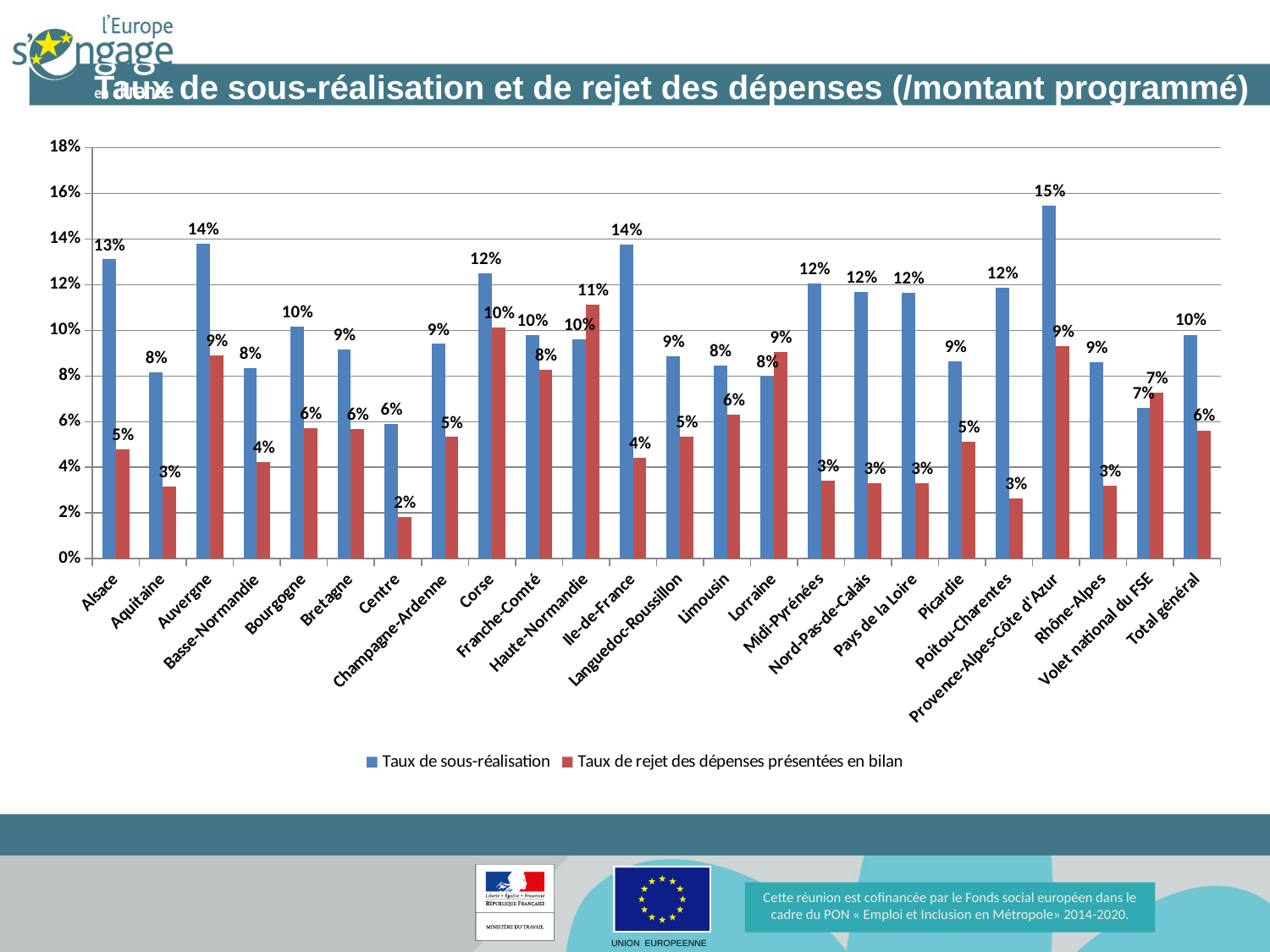
What is the Taux de sous-réalisation for Total général? 10% Which category has the highest Taux de rejet des dépenses présentées en bilan? Haute-Normandie Which is larger: the Taux de sous-réalisation for Alsace or for Aquitaine? Alsace Which region has the highest Taux de sous-réalisation? Provence-Alpes-Côte d'Azur How many series does the legend list? 2 Is the Taux de sous-réalisation for Auvergne greater or less than 12%? greater Which category has the lowest Taux de rejet des dépenses présentées en bilan? Centre What is the Taux de sous-réalisation for Alsace? 13% What kind of chart is shown on the slide? Bar chart What is the difference between the Taux de sous-réalisation and the Taux de rejet des dépenses présentées en bilan for Ile-de-France? 10 percentage points How many categories are shown on the x axis? 24 What is the Taux de rejet des dépenses présentées en bilan for Centre? 2%